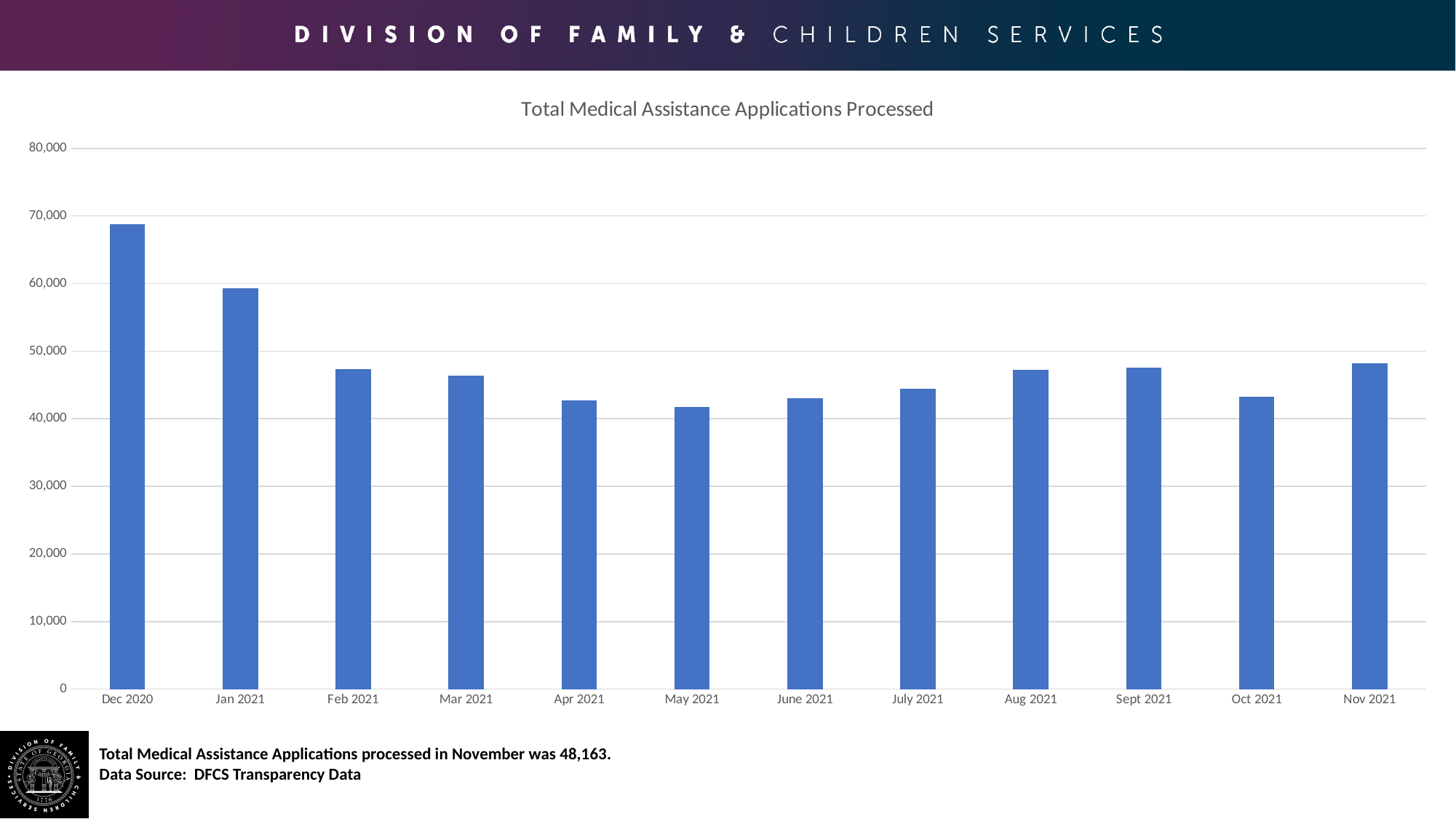
Do the values rise or fall from Dec 2020 to Feb 2021? fall Is the value for Dec 2020 greater or less than 60,000? greater Which is larger, the value for Dec 2020 or the value for Jan 2021? Dec 2020 What type of chart is shown on the slide? bar chart Which month has the highest number of Total Medical Assistance Applications Processed? Dec 2020 What is the title of the chart? Total Medical Assistance Applications Processed Is the value for Feb 2021 greater or less than 50,000? less Is the value for Jan 2021 greater or less than 50,000? greater How many months are plotted on the chart? 12 Which is larger, the value for Feb 2021 or the value for Apr 2021? Feb 2021 How many Total Medical Assistance Applications were processed in Nov 2021? 48,163